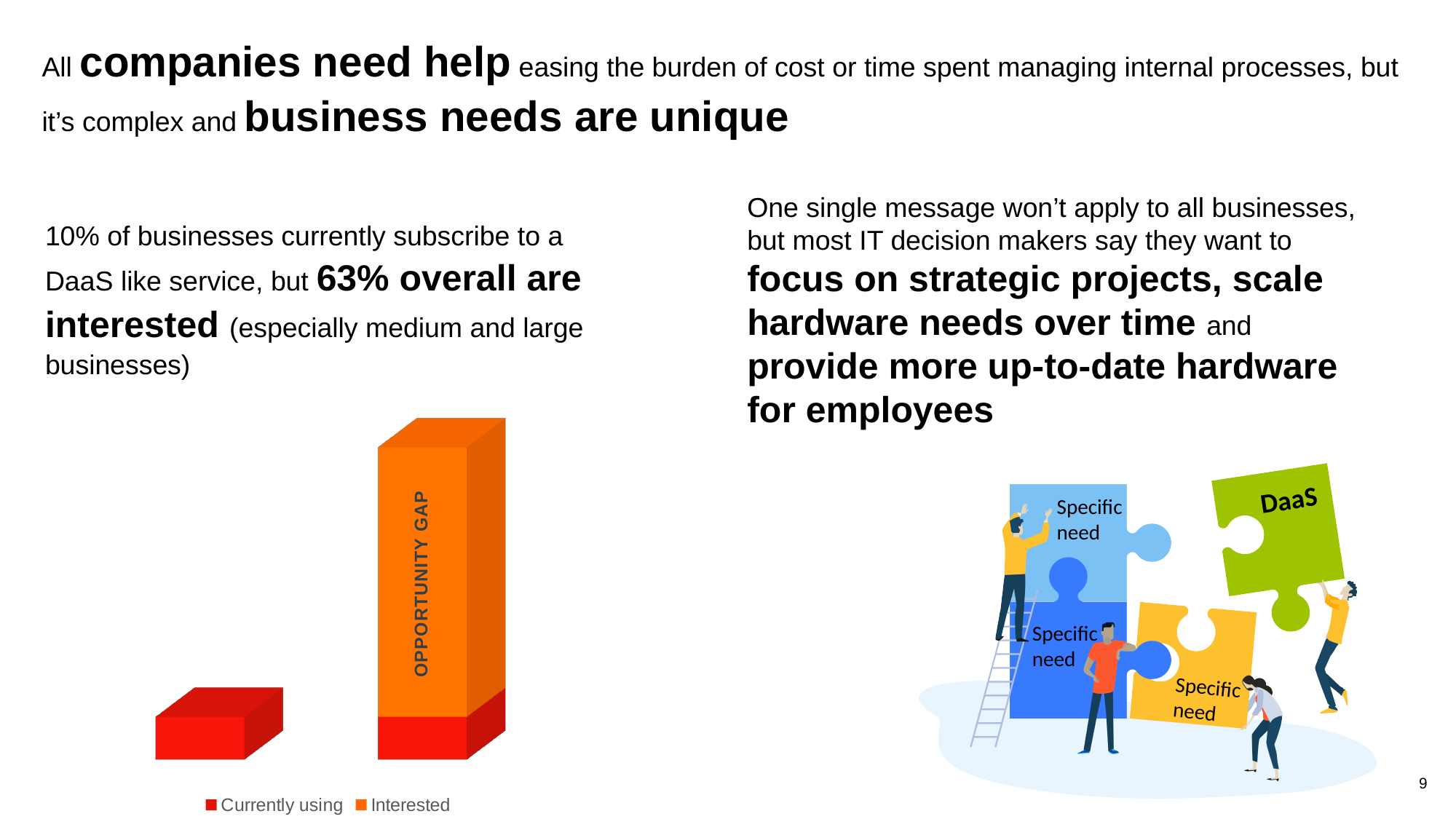
What kind of chart is shown on the slide? bar chart What are the two entries in the chart legend? Currently using, Interested How many series does the chart legend list? 2 In the right bar, which series occupies the larger segment, Currently using or Interested? Interested What text is written vertically on the orange segment of the right bar? OPPORTUNITY GAP Which bar is taller, the left bar or the right bar? the right bar How many bars are plotted in the chart? 2